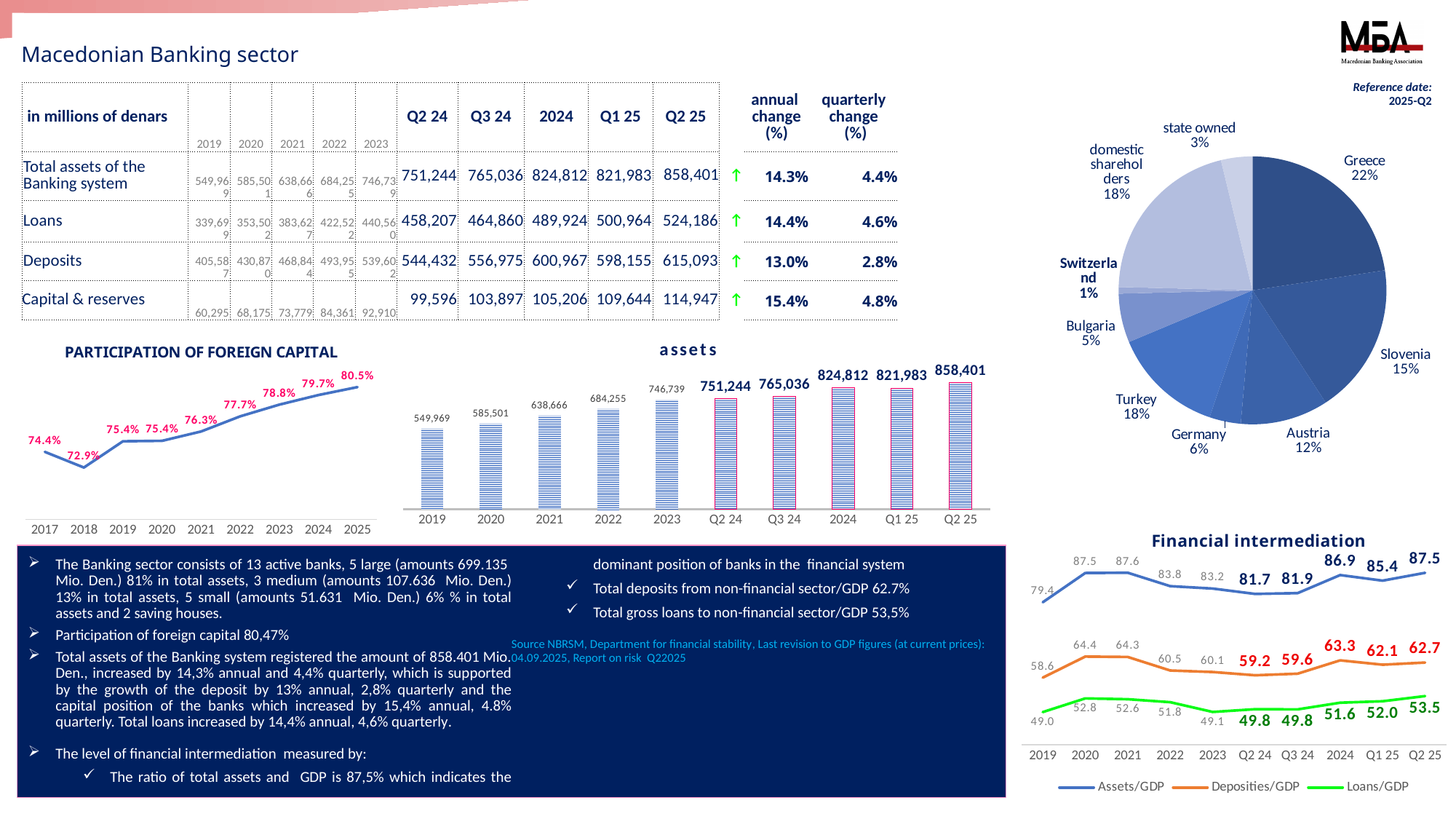
How many bars are shown in the 'assets' bar chart? 10 In the 'assets' bar chart, what is the difference between the values for Q2 25 and Q1 25? 36,418 In the 'PARTICIPATION OF FOREIGN CAPITAL' chart, what is the value for 2018? 72.9% In the 'assets' bar chart, what is the value for Q2 25? 858,401 How many series does the legend of the 'Financial intermediation' chart list? 3 In the 'Financial intermediation' chart, what is the Loans/GDP value for Q2 25? 53.5 In the pie chart, which slice is the smallest? Switzerland What type of chart is 'PARTICIPATION OF FOREIGN CAPITAL'? line chart In the 'PARTICIPATION OF FOREIGN CAPITAL' chart, which year has the highest value? 2025 In the pie chart, what share does Greece hold? 22% In the 'assets' bar chart, which period has the lowest value? 2019